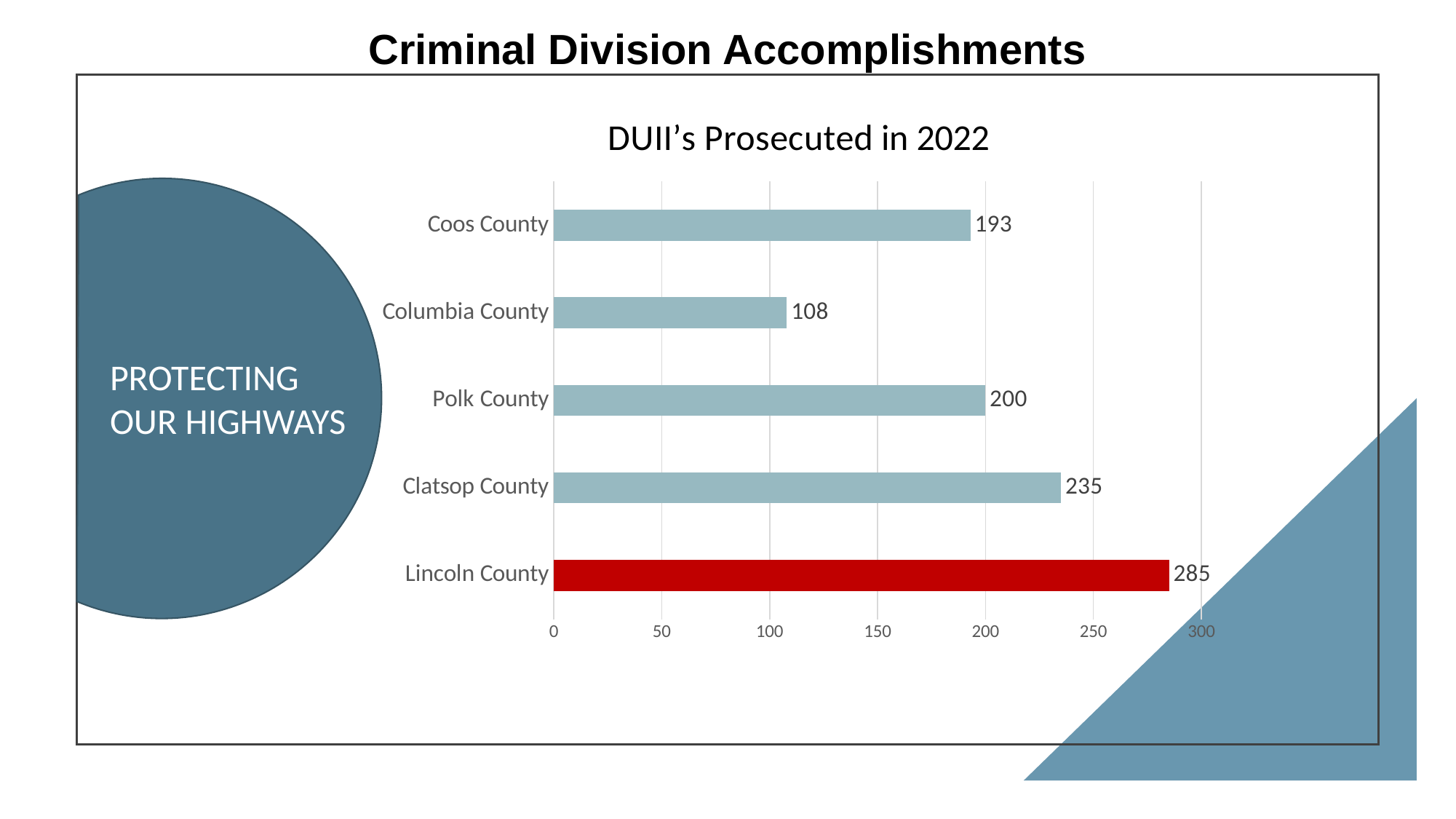
What is the title of the chart? DUII's Prosecuted in 2022 What is the difference between the values for Lincoln County and Clatsop County? 50 What is the difference between the values for Polk County and Columbia County? 92 Which county has the highest number of DUIIs prosecuted? Lincoln County What is the value for Columbia County? 108 What is the value for Lincoln County? 285 What is the value for Coos County? 193 What kind of chart is shown on the slide? bar chart Is the value for Coos County greater or less than 200? less Which county has the lowest number of DUIIs prosecuted? Columbia County How many counties are shown in the chart? 5 Which is larger, the value for Clatsop County or the value for Polk County? Clatsop County